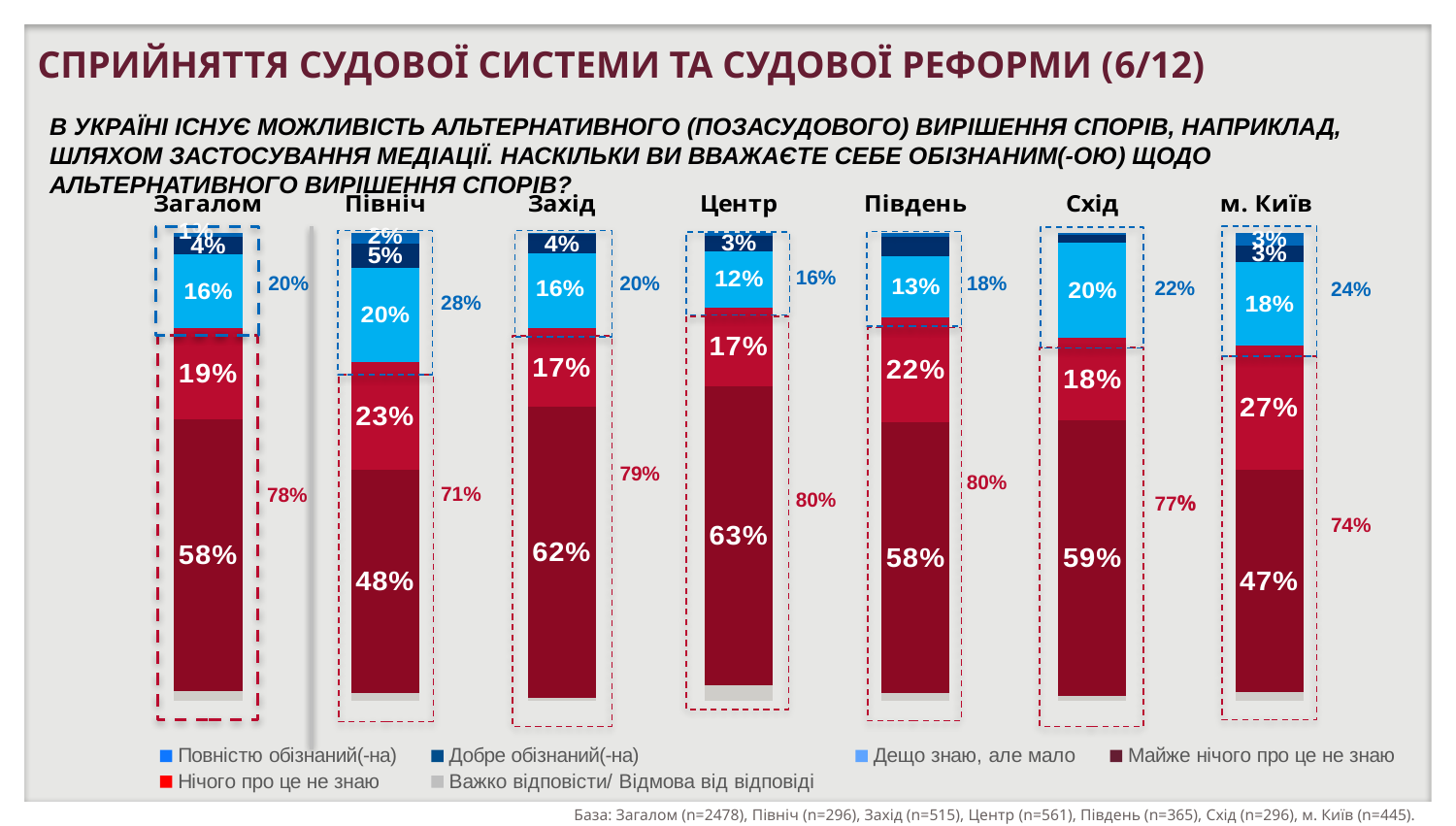
Which has a larger 'Дещо знаю, але мало' value, Схід or Південь? Схід How many series does the legend list? 6 What kind of chart is shown on the slide? Stacked bar chart Which category has the largest value in its bottom (dark red) segment? Центр Which category has the smallest value in its bottom (dark red) segment? м. Київ How many categories (regions, including Загалом) are shown along the x axis? 7 What combined value is shown by the red bracket next to the Центр bar? 80% What is the value of the 'Дещо знаю, але мало' segment for Загалом? 16% What is the value of the 'Дещо знаю, але мало' segment for Центр? 12% What is the difference between the 'Дещо знаю, але мало' values for Північ and Центр? 8 percentage points What combined value is shown by the blue bracket next to the Північ bar? 28% What is the value of the 'Добре обізнаний(-на)' segment for Північ? 5%